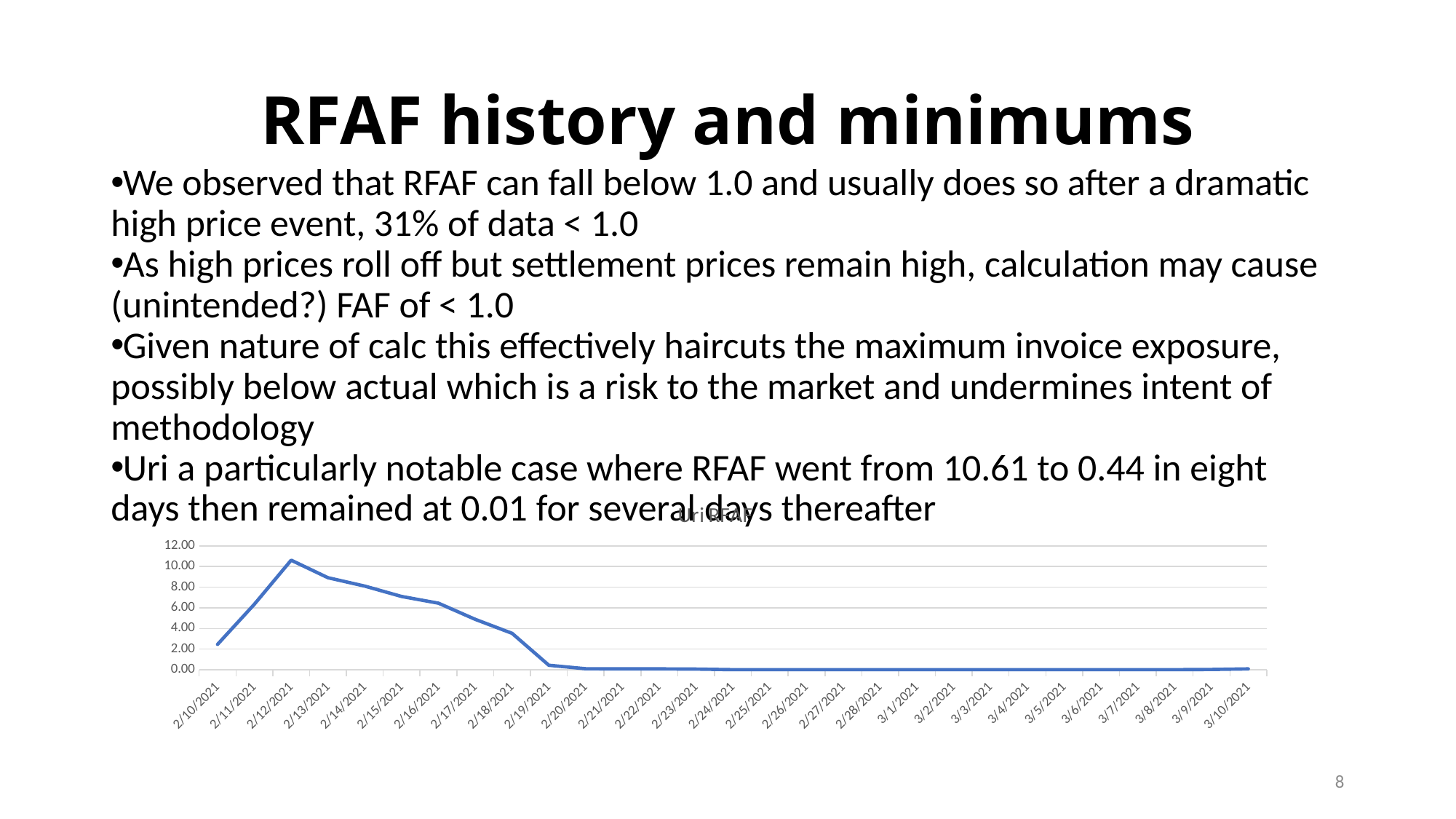
On which date does the line reach its highest value? 2/12/2021 How many dates are plotted along the x axis? 29 Is the value for 2/12/2021 greater or less than 8.00? greater Is the value for 2/17/2021 greater or less than 6.00? less Is the value for 2/10/2021 greater or less than 4.00? less Which date has the larger value, 2/10/2021 or 2/12/2021? 2/12/2021 What kind of chart is shown on the slide? line chart Which date has the larger value, 2/13/2021 or 2/17/2021? 2/13/2021 Do the values rise or fall from 2/12/2021 to 2/19/2021? fall